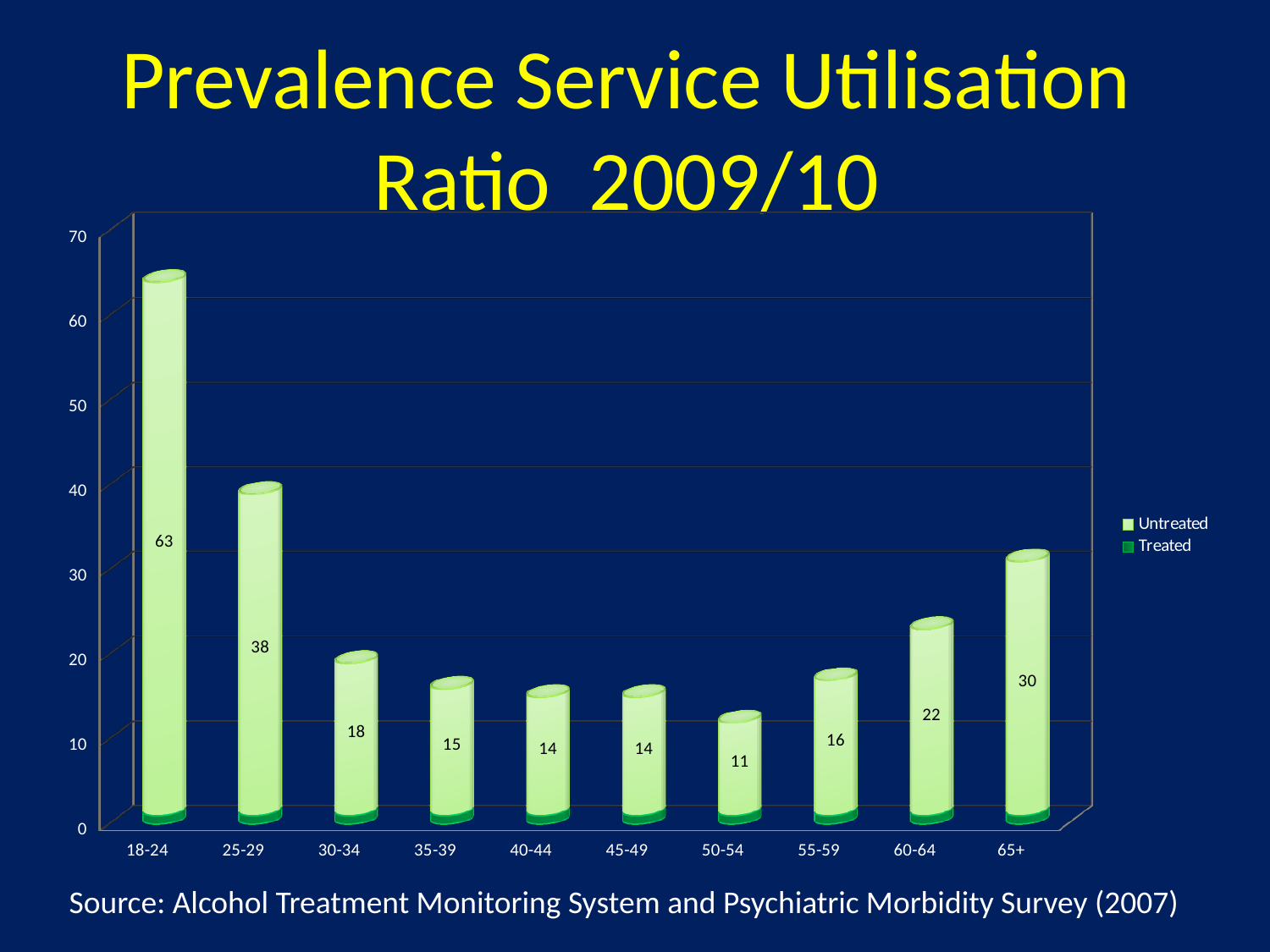
What is the difference between the Untreated values for 18-24 and 25-29? 25 What is the Untreated value for the 18-24 age group? 63 What is the Untreated value for the 50-54 age group? 11 Which has a larger Untreated value, 60-64 or 65+? 65+ Is the total bar height for the 25-29 age group greater or less than 30? greater Which age group has the lowest Untreated value? 50-54 Which age group has the highest Untreated value? 18-24 How many series does the legend list? 2 What kind of chart is shown on the slide? Stacked bar chart What are the two series named in the legend? Untreated and Treated What is the Untreated value for the 65+ age group? 30 How many age groups are shown on the x axis? 10